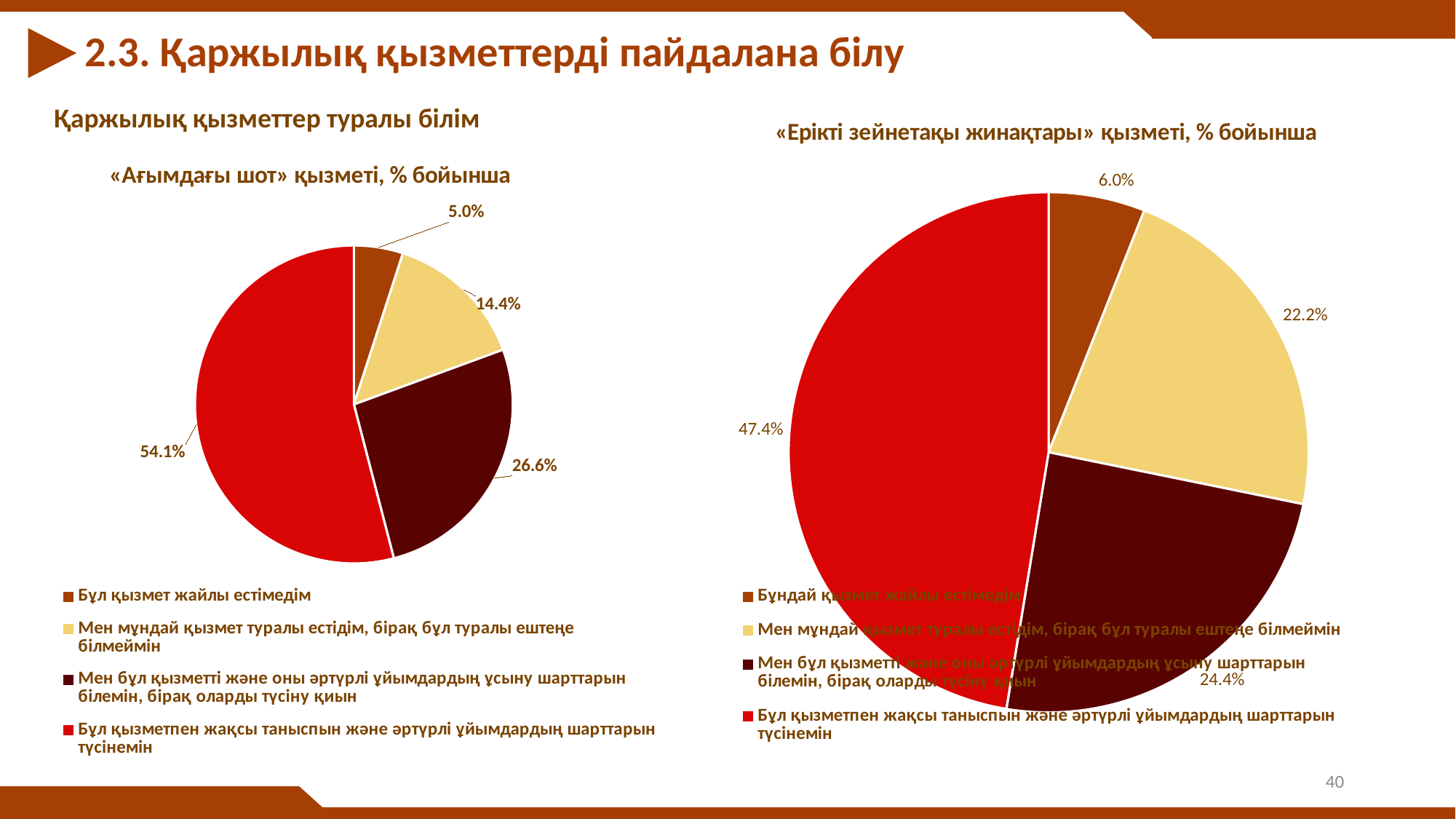
In the «Ерікті зейнетақы жинақтары» қызметі, % бойынша chart, what is the difference between the 47.4% slice and the 6.0% slice? 41.4% In the «Ерікті зейнетақы жинақтары» қызметі, % бойынша chart, what is the share for «Мен бұл қызметті және оны әртүрлі ұйымдардың ұсыну шарттарын білемін, бірақ оларды түсіну қиын»? 24.4% How many slices does the «Ағымдағы шот» қызметі, % бойынша pie chart have? 4 What kind of chart is the «Ағымдағы шот» қызметі, % бойынша chart? pie chart In the «Ағымдағы шот» қызметі, % бойынша chart, what is the share for «Бұл қызмет жайлы естімедім»? 5.0% How many entries does the legend of the «Ерікті зейнетақы жинақтары» қызметі, % бойынша chart list? 4 In the «Ағымдағы шот» қызметі, % бойынша chart, what is the difference between the 26.6% slice and the 14.4% slice? 12.2% In the «Ағымдағы шот» қызметі, % бойынша chart, what is the share for «Бұл қызметпен жақсы таныспын және әртүрлі ұйымдардың шарттарын түсінемін»? 54.1% Which is larger: the «Бұл қызметпен жақсы таныспын және әртүрлі ұйымдардың шарттарын түсінемін» share in the «Ағымдағы шот» chart or in the «Ерікті зейнетақы жинақтары» chart? «Ағымдағы шот» (54.1%) In the «Ағымдағы шот» қызметі, % бойынша chart, which category has the smallest slice? Бұл қызмет жайлы естімедім In the «Ерікті зейнетақы жинақтары» қызметі, % бойынша chart, what is the share for «Мен мұндай қызмет туралы естідім, бірақ бұл туралы ештеңе білмеймін»? 22.2% In the «Ерікті зейнетақы жинақтары» қызметі, % бойынша chart, which category has the largest slice? Бұл қызметпен жақсы таныспын және әртүрлі ұйымдардың шарттарын түсінемін